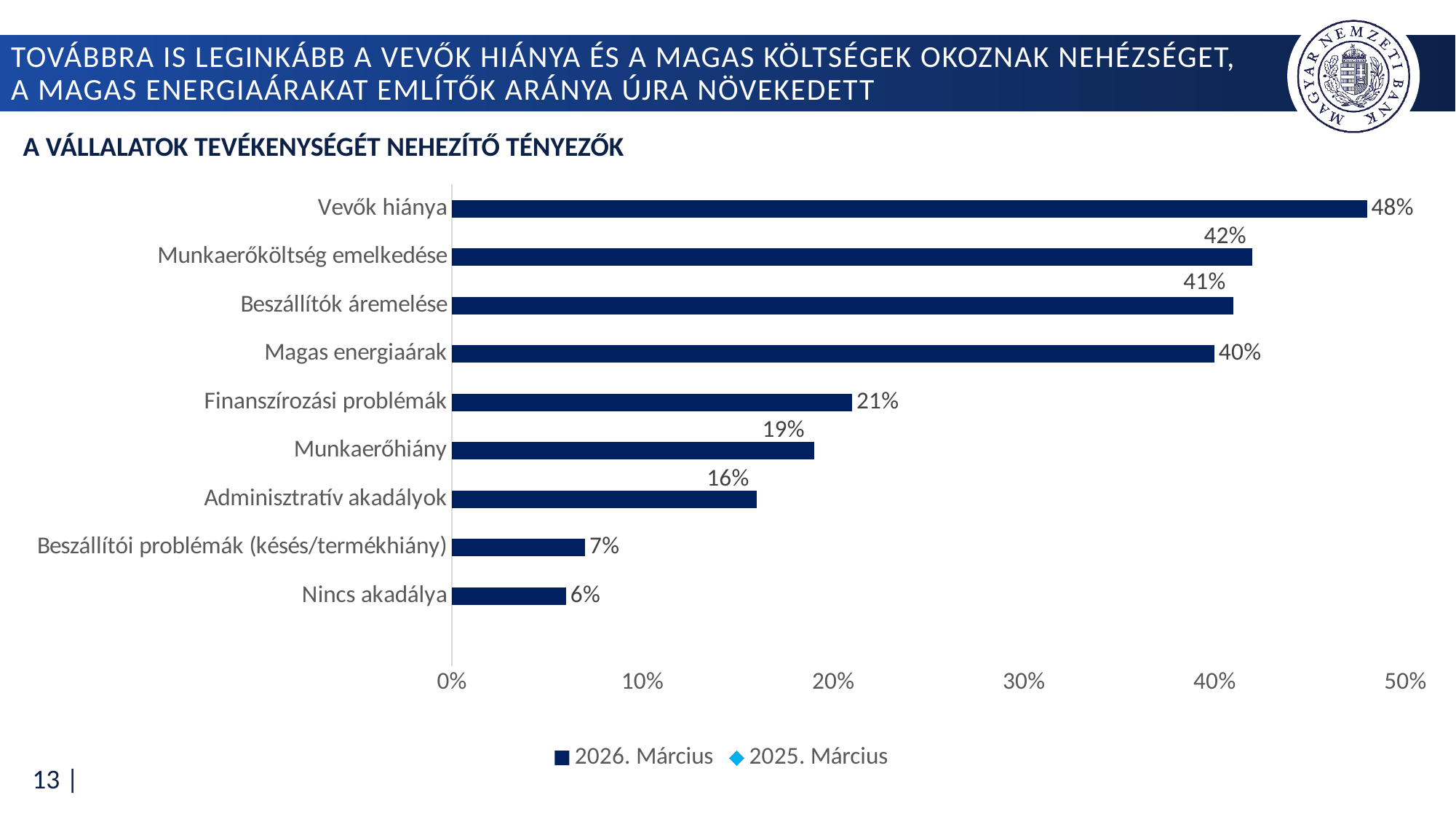
What is the value for Vevők hiánya in the 2026. Március series? 48% What is the value for Adminisztratív akadályok in the 2026. Március series? 16% Which category has the lowest value in the chart? Nincs akadálya How many categories are shown on the chart? 9 Is the value for Beszállítók áremelése greater or less than 30%? greater What is the value for Magas energiaárak in the 2026. Március series? 40% How many series does the legend list? 2 Which is larger, the value for Finanszírozási problémák or the value for Munkaerőhiány? Finanszírozási problémák Which category has the highest value in the chart? Vevők hiánya What kind of chart is shown on the slide? Bar chart What is the title of the chart? A vállalatok tevékenységét nehezítő tényezők What is the difference between the values for Vevők hiánya and Munkaerőköltség emelkedése? 6 percentage points